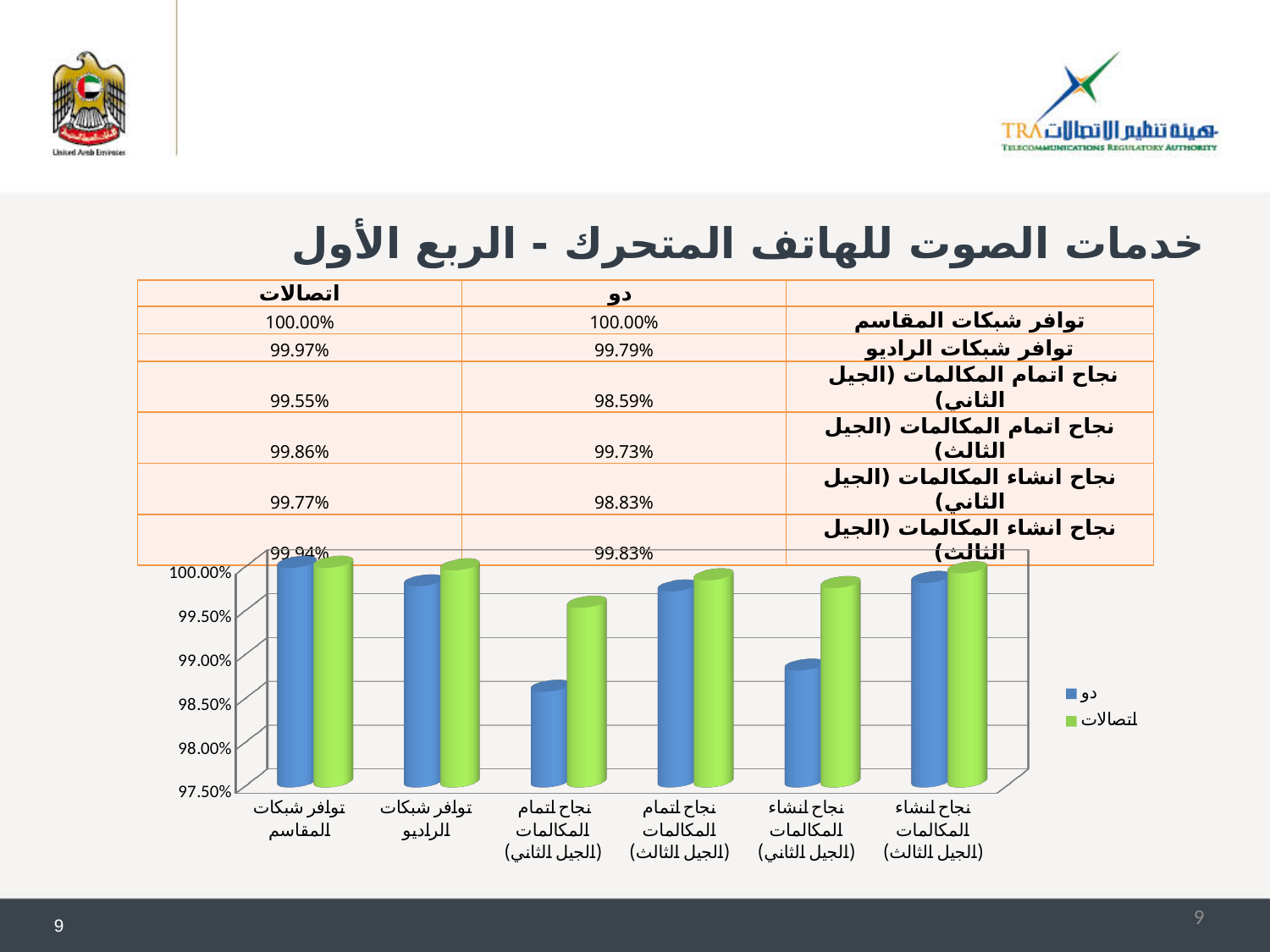
What kind of chart is shown on the slide? bar chart For نجاح اتمام المكالمات (الجيل الثاني), which is larger, the دو value or the اتصالات value? اتصالات Which series is shown in green in the chart? اتصالات How many categories are shown on the x axis of the chart? 6 According to the table on the slide, what is the difference between the اتصالات and دو values for نجاح اتمام المكالمات (الجيل الثاني)? 0.96% For which category is the اتصالات bar the lowest? نجاح اتمام المكالمات (الجيل الثاني) What is the lowest value shown on the chart's vertical axis? 97.50% Is the دو value for نجاح اتمام المكالمات (الجيل الثاني) greater or less than 99.00%? less According to the table on the slide, what is the دو value for نجاح انشاء المكالمات (الجيل الثاني)? 98.83% How many series does the chart legend list? 2 For which category is the دو bar the lowest? نجاح اتمام المكالمات (الجيل الثاني) Is the اتصالات value for توافر شبكات الراديو greater or less than 99.50%? greater